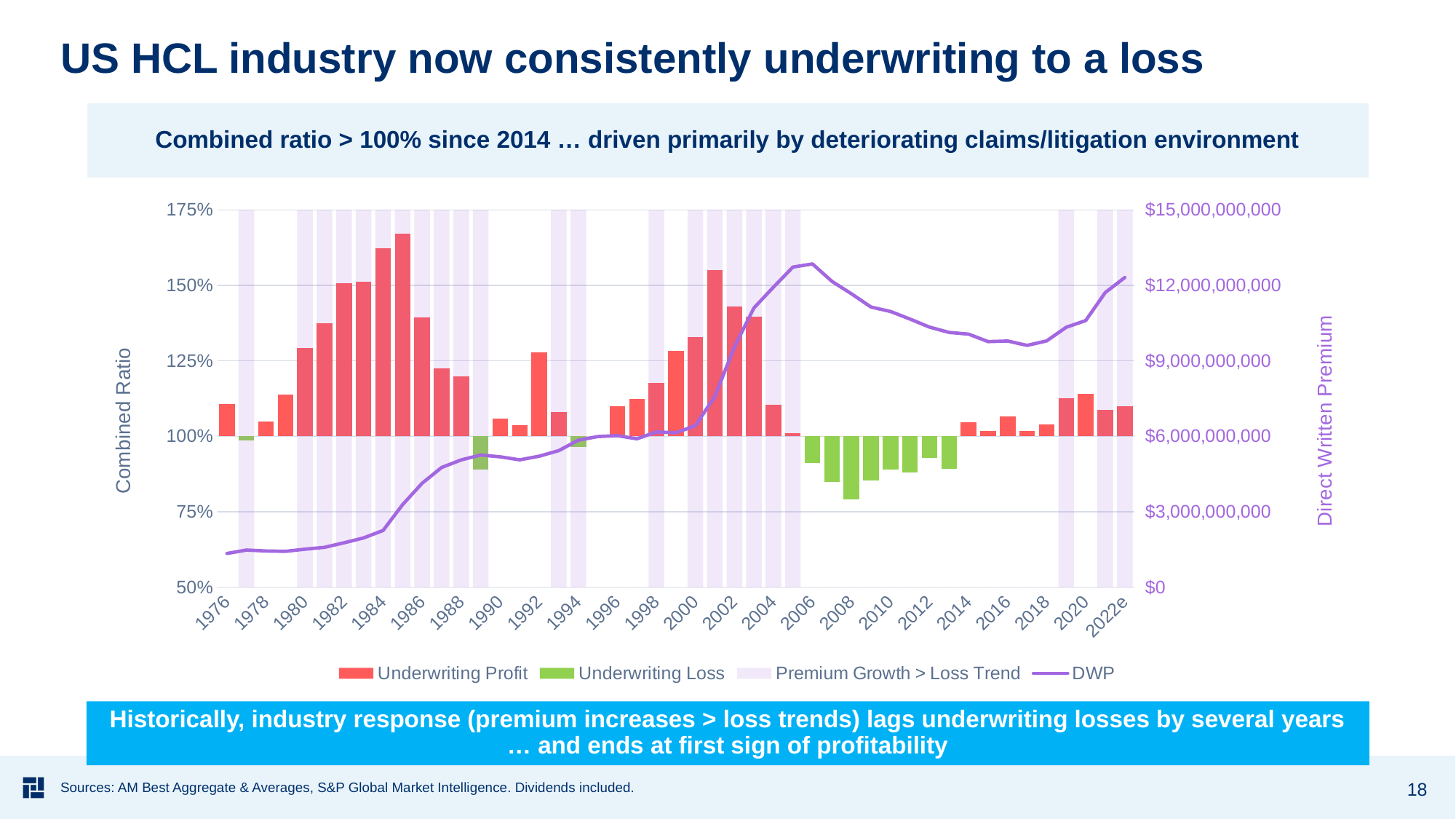
Which year has the larger combined ratio, 1985 or 2001? 1985 What colour are the Underwriting Loss bars? Green Is the DWP value for 2006 greater or less than $12,000,000,000? greater Which year has the highest combined ratio bar? 1985 Is the DWP value for 1976 greater or less than $3,000,000,000? less Is the combined ratio for 1985 greater or less than 150%? greater What is the title of the left vertical axis? Combined Ratio How many series does the legend list? 4 Does the DWP line rise or fall from 1976 to 2006? Rise Which year has the lowest combined ratio bar? 2008 What kind of chart is shown on the slide? A combined bar and line chart